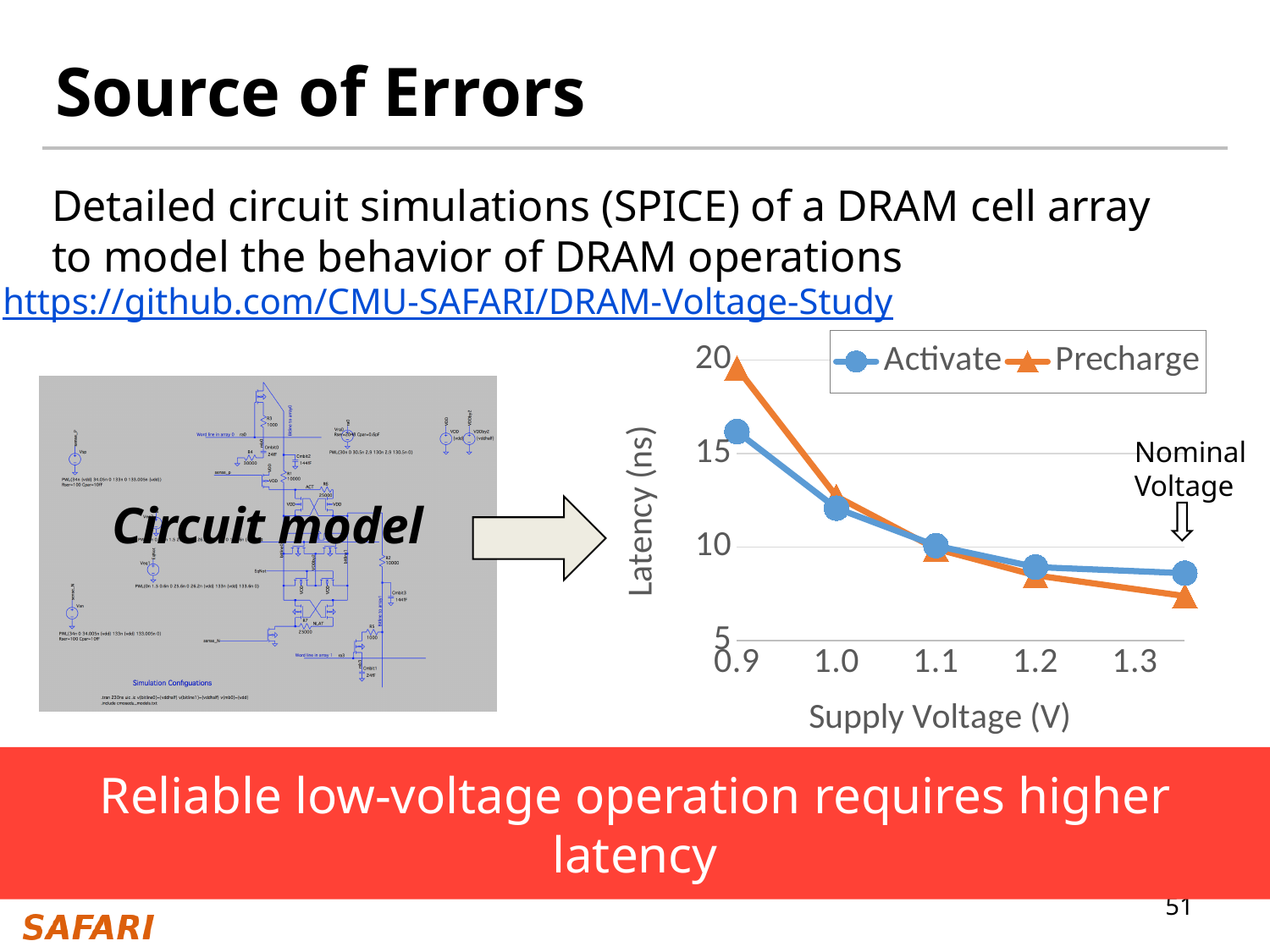
Is the Activate latency at 1.2 V greater or less than 10 ns? less How many series does the chart's legend list? 2 What is the title of the chart's y axis? Latency (ns) At which supply voltage is the Precharge latency highest? 0.9 Is the Precharge latency at 0.9 V greater or less than 15 ns? greater Does the Precharge latency rise or fall as supply voltage increases along the x axis? Fall At 0.9 V, which series has the higher latency, Activate or Precharge? Precharge Is the Precharge latency at 1.0 V greater or less than 10 ns? greater Does the Activate latency rise or fall as supply voltage increases along the x axis? Fall What are the two series named in the chart's legend? Activate and Precharge What kind of chart is shown on the slide? Line chart